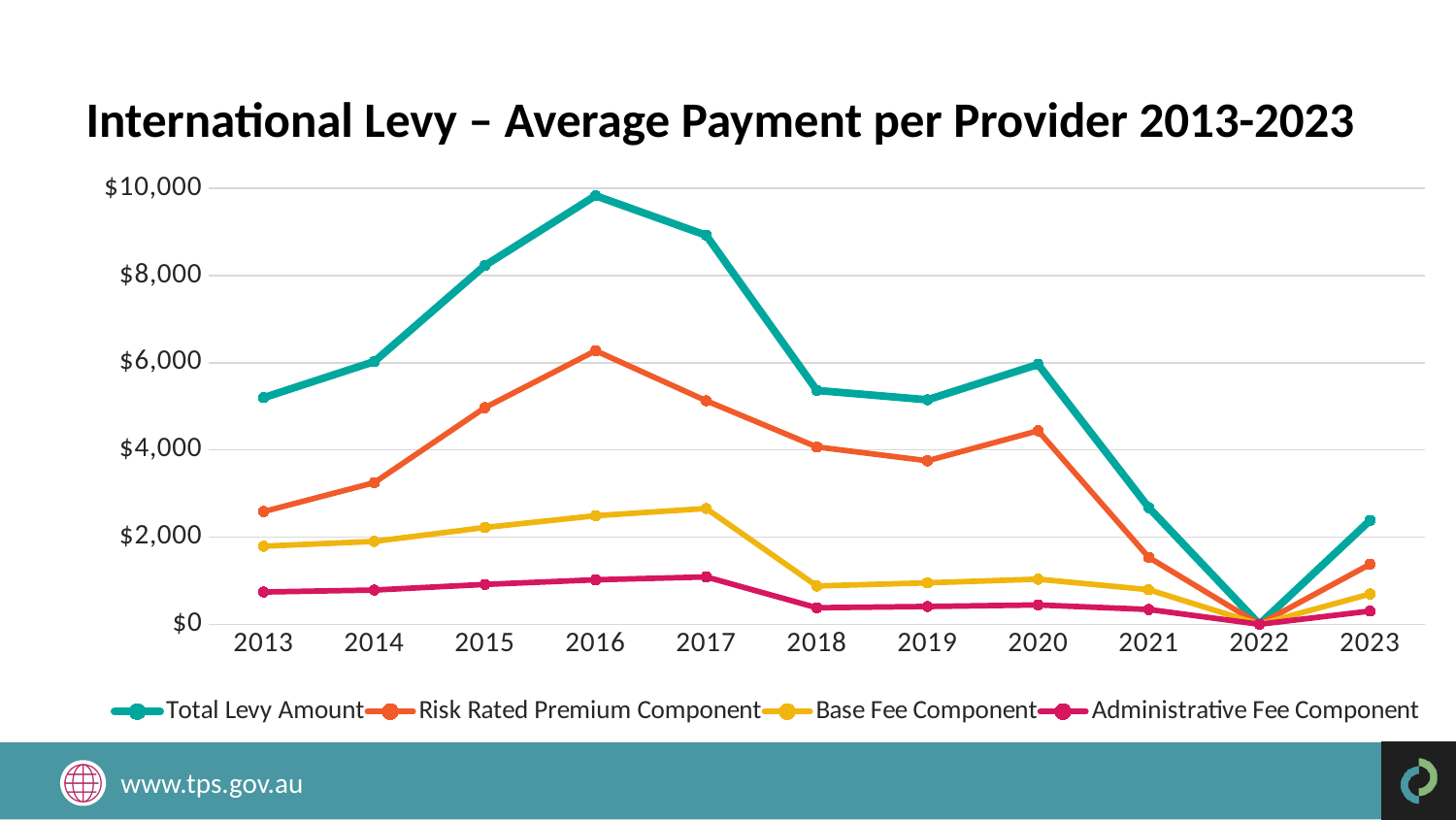
How many years are plotted along the x axis? 11 Is the Total Levy Amount for 2016 greater or less than $8,000? greater How many series does the legend list? 4 In which year is the Total Levy Amount lowest? 2022 What kind of chart is shown on the slide? Line chart In which year is the Total Levy Amount highest? 2016 Is the Base Fee Component for 2017 greater or less than $2,000? greater Is the Risk Rated Premium Component for 2013 greater or less than $4,000? less What is the title of the chart? International Levy – Average Payment per Provider 2013-2023 In which year is the Risk Rated Premium Component highest? 2016 Which is larger, the Total Levy Amount in 2013 or in 2014? 2014 Does the Total Levy Amount rise or fall from 2017 to 2018? Falls